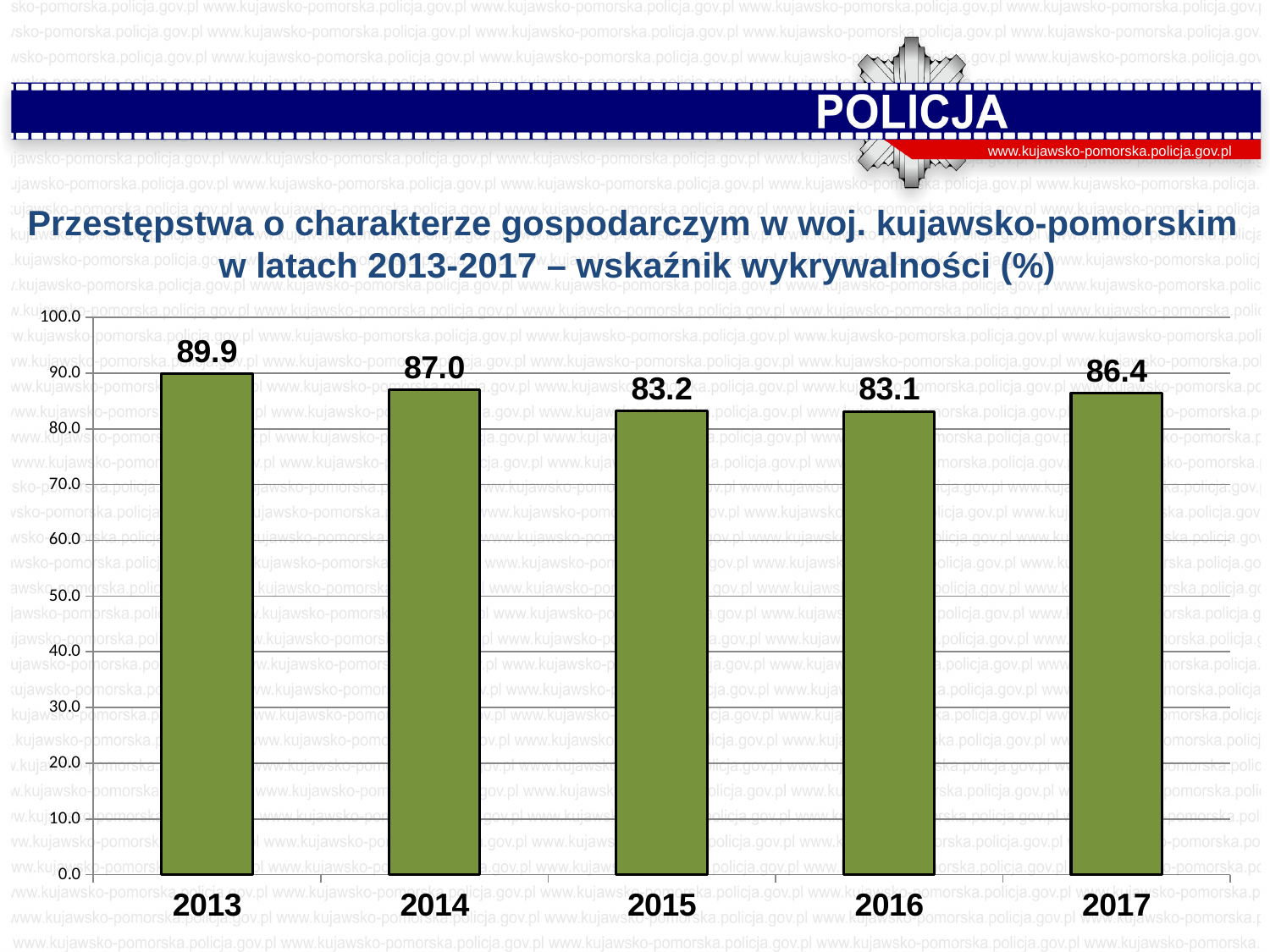
Is the value for 2015 greater or less than 90.0? less What is the difference between the values for 2013 and 2014? 2.9 What kind of chart is shown on the slide? bar chart Which year has the lowest value? 2016 What is the value shown for 2015? 83.2 What is the detection rate value shown for 2013? 89.9 Which year has the highest value? 2013 Which is larger, the value for 2014 or the value for 2017? 2014 Do the values rise or fall from 2013 to 2016? fall What is the value shown for 2017? 86.4 How many years are shown on the x axis? 5 What is the difference between the values for 2017 and 2016? 3.3